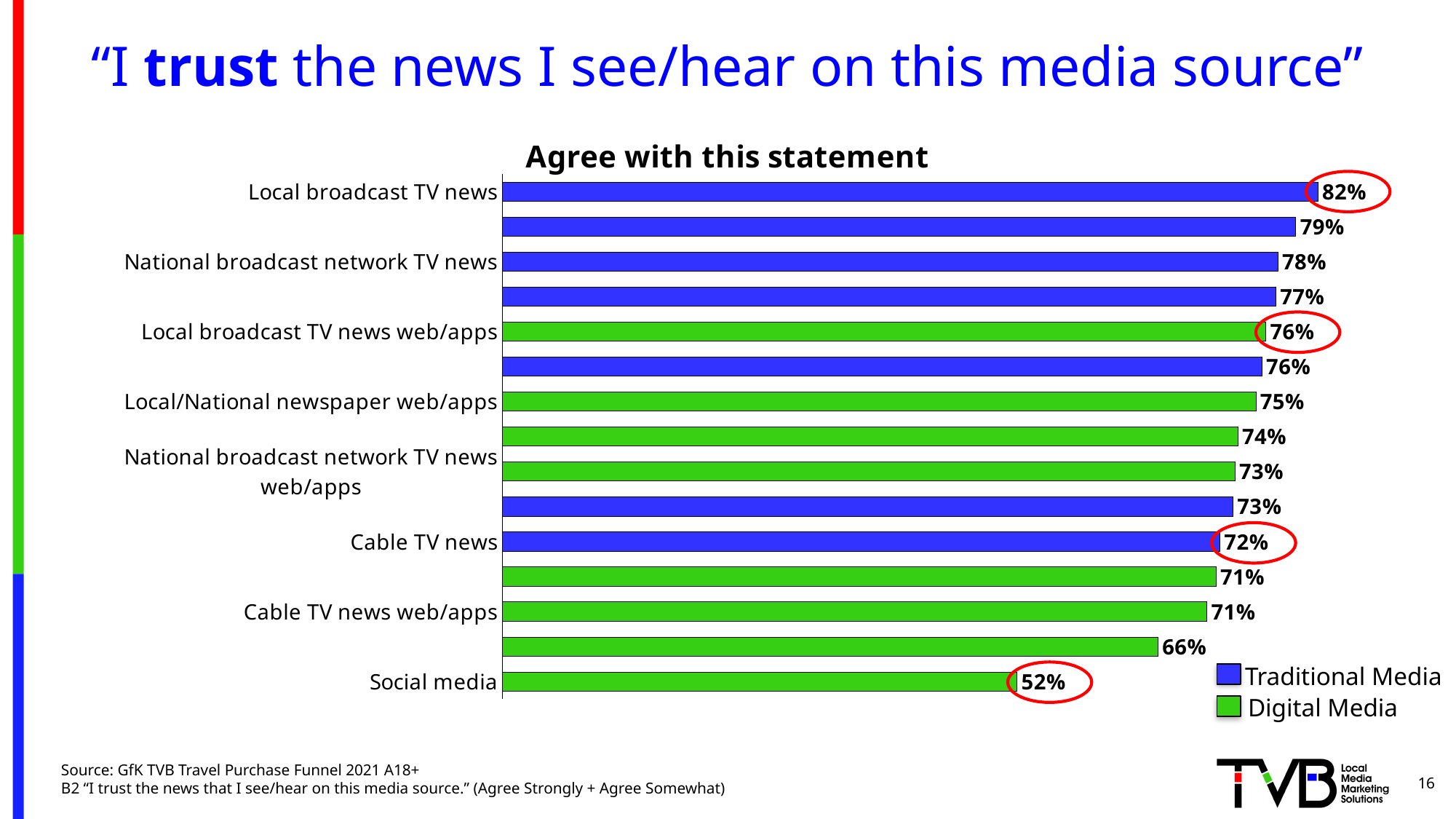
How many bars are plotted in the chart? 15 What percentage is shown for Cable TV news? 72% How many series does the legend list? 2 What is the value shown for Social media? 52% Which is higher, National broadcast network TV news or Cable TV news? National broadcast network TV news How many percentage points higher is Local broadcast TV news than Social media? 30 percentage points What percentage is shown for Local/National newspaper web/apps? 75% What type of chart is shown on the slide? Bar chart What percentage agree they trust the news on Local broadcast TV news? 82% Which media source has the highest share agreeing with the statement? Local broadcast TV news What is the value for Local broadcast TV news web/apps? 76% Which media source has the lowest share agreeing with the statement? Social media